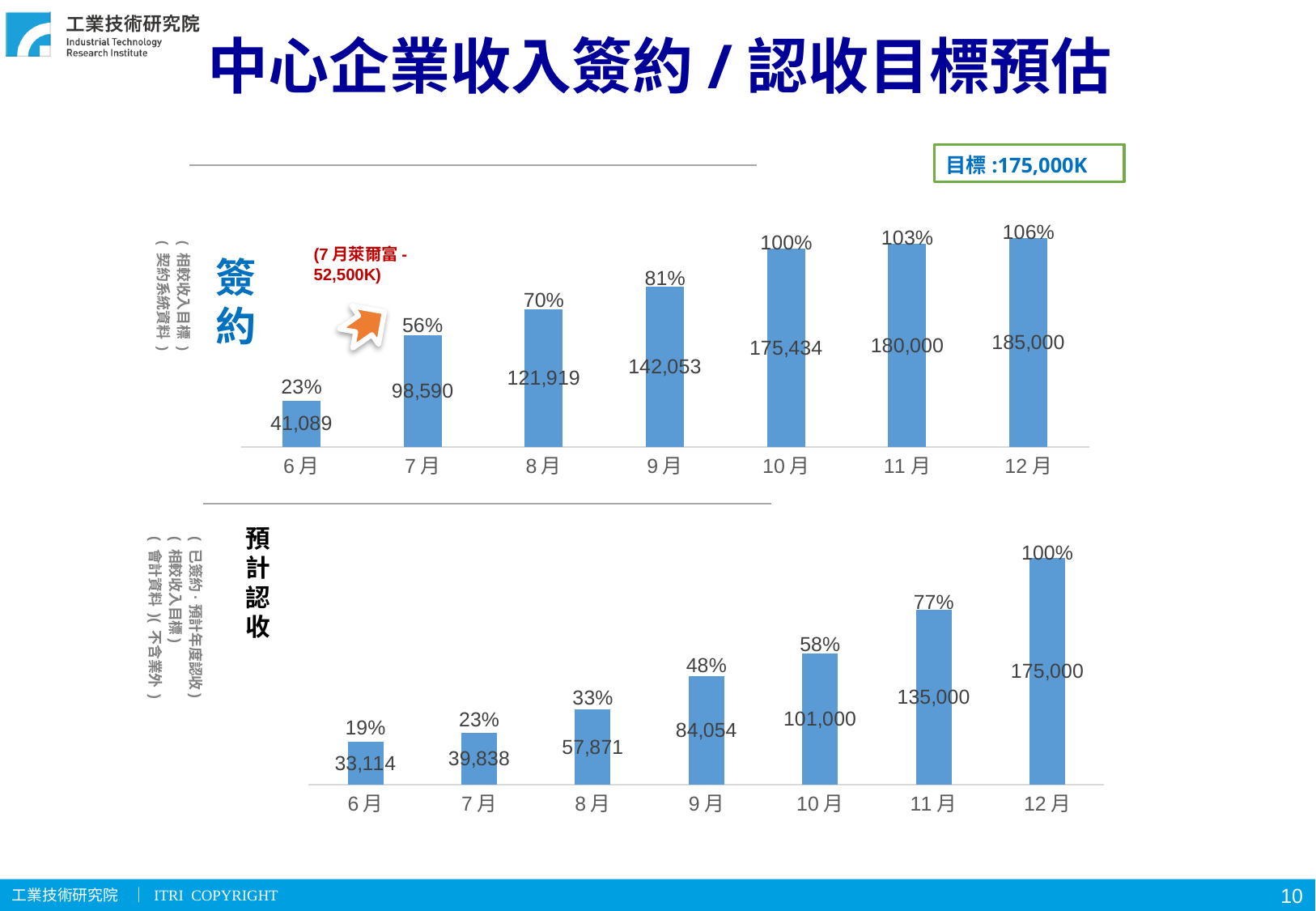
In the top chart (簽約), what percentage is shown above the 9月 bar? 81% In the top chart (簽約), do the values rise or fall from 6月 to 12月? Rise In the top chart (簽約), which month has the highest value? 12月 In the bottom chart (預計認收), what is the value for 10月? 101,000 In the top chart (簽約), what is the value for 7月? 98,590 In the top chart (簽約), what is the difference between the 12月 and 11月 values? 5,000 In the bottom chart (預計認收), which month has the lowest value? 6月 What type of chart is the bottom chart (預計認收)? Bar chart How many months are shown on the x axis of the top chart (簽約)? 7 In the bottom chart (預計認收), what is the difference between the 12月 and 11月 values? 40,000 In the bottom chart (預計認收), which is larger, the value for 8月 or the value for 9月? 9月 In the bottom chart (預計認收), what percentage is shown above the 11月 bar? 77%